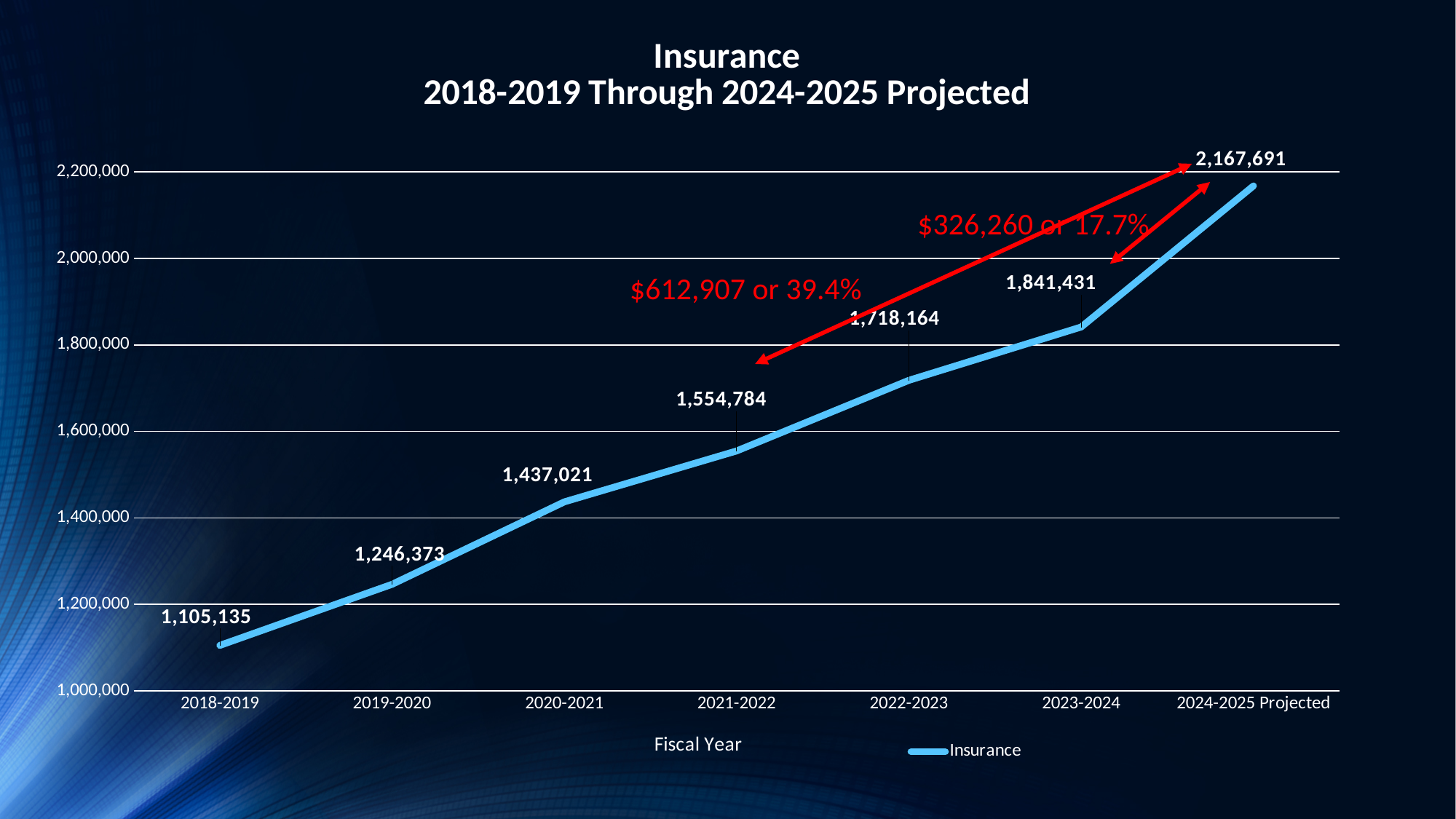
How many fiscal years are plotted on the chart? 7 Which fiscal year has the lowest Insurance value? 2018-2019 What kind of chart is shown on the slide? line chart Which is larger, the Insurance value for 2019-2020 or for 2020-2021? 2020-2021 What is the Insurance value for 2020-2021? 1,437,021 What is the Insurance value for 2021-2022? 1,554,784 What is the difference between the Insurance values for 2023-2024 and 2022-2023? 123,267 Do the Insurance values rise or fall from 2018-2019 to 2024-2025 Projected? rise What is the Insurance value for 2024-2025 Projected? 2,167,691 What is the Insurance value for 2018-2019? 1,105,135 Is the Insurance value for 2022-2023 greater or less than 1,800,000? less Which fiscal year has the highest Insurance value? 2024-2025 Projected